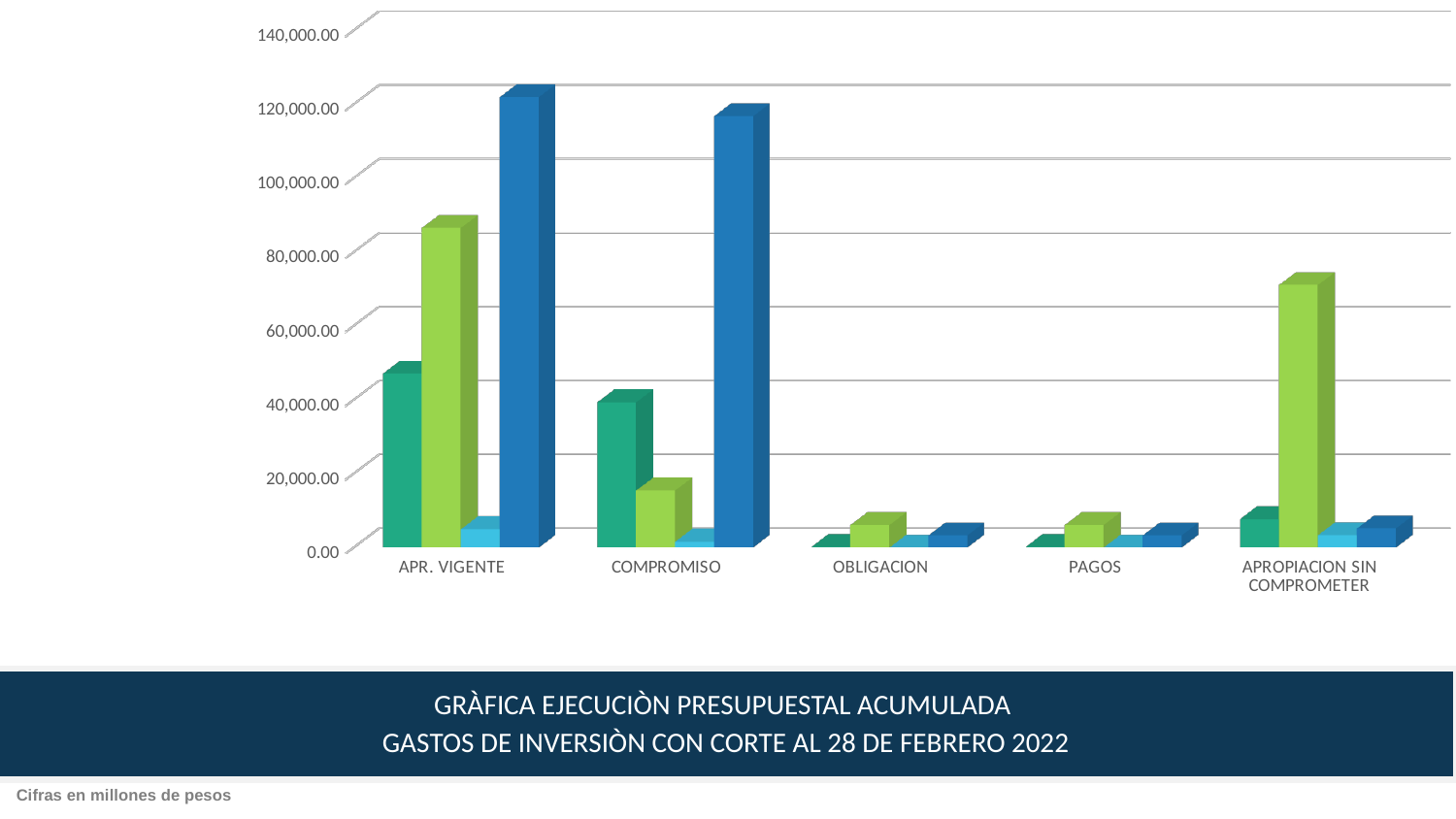
Is the light green bar for COMPROMISO greater or less than 20,000.00? less How many categories are shown on the x axis of the chart? 5 What kind of chart is shown on the slide? bar chart Which category has the tallest bar in the chart? APR. VIGENTE How many bars are plotted for each category in the chart? 4 Which category has the tallest light green bar? APR. VIGENTE According to the note on the slide, in what units are the figures expressed? millones de pesos Is the teal bar for APR. VIGENTE greater or less than 60,000.00? less Is the light green bar for APROPIACION SIN COMPROMETER greater or less than 60,000.00? greater Which is larger: the teal bar for APR. VIGENTE or the teal bar for COMPROMISO? APR. VIGENTE Which is larger: the light green bar for APR. VIGENTE or the light green bar for APROPIACION SIN COMPROMETER? APR. VIGENTE